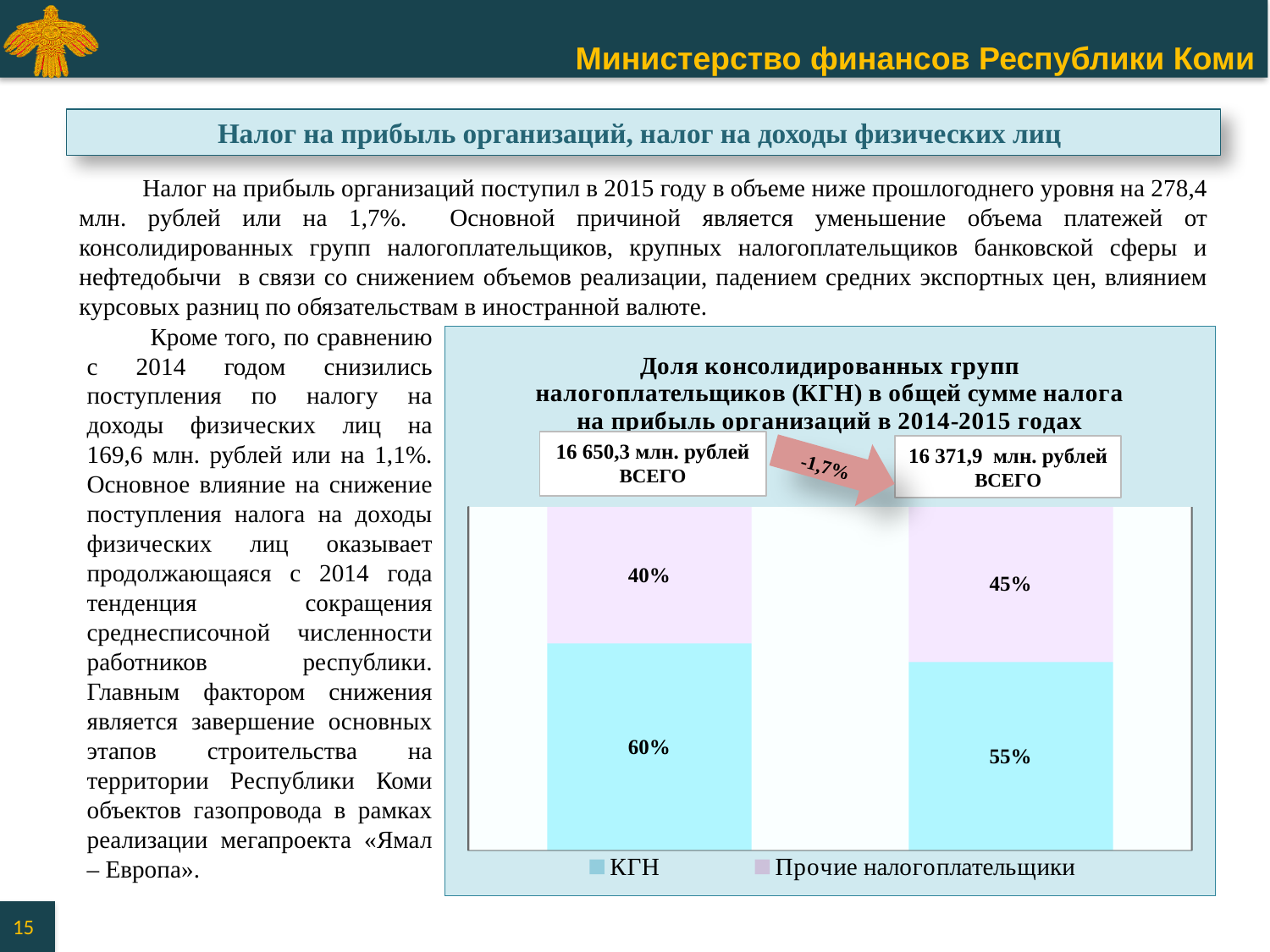
In the right bar (total 16 371,9 млн. рублей), what is the share for КГН? 55% In the right bar (total 16 371,9 млн. рублей), what is the share for Прочие налогоплательщики? 45% What percentage change is shown on the arrow between the two total labels above the bars? -1,7% Does the КГН share rise or fall from the left bar to the right bar? fall In the right bar, which is larger: the КГН share or the Прочие налогоплательщики share? КГН How many stacked bars are plotted in the chart? 2 What kind of chart is shown on the slide? bar chart In the left bar (total 16 650,3 млн. рублей), what is the share for КГН? 60% By how many percentage points does the КГН share in the left bar exceed the КГН share in the right bar? 5% In the left bar (total 16 650,3 млн. рублей), what is the share for Прочие налогоплательщики? 40% What is the total of the two segments in the left bar? 100% How many series does the chart legend list? 2